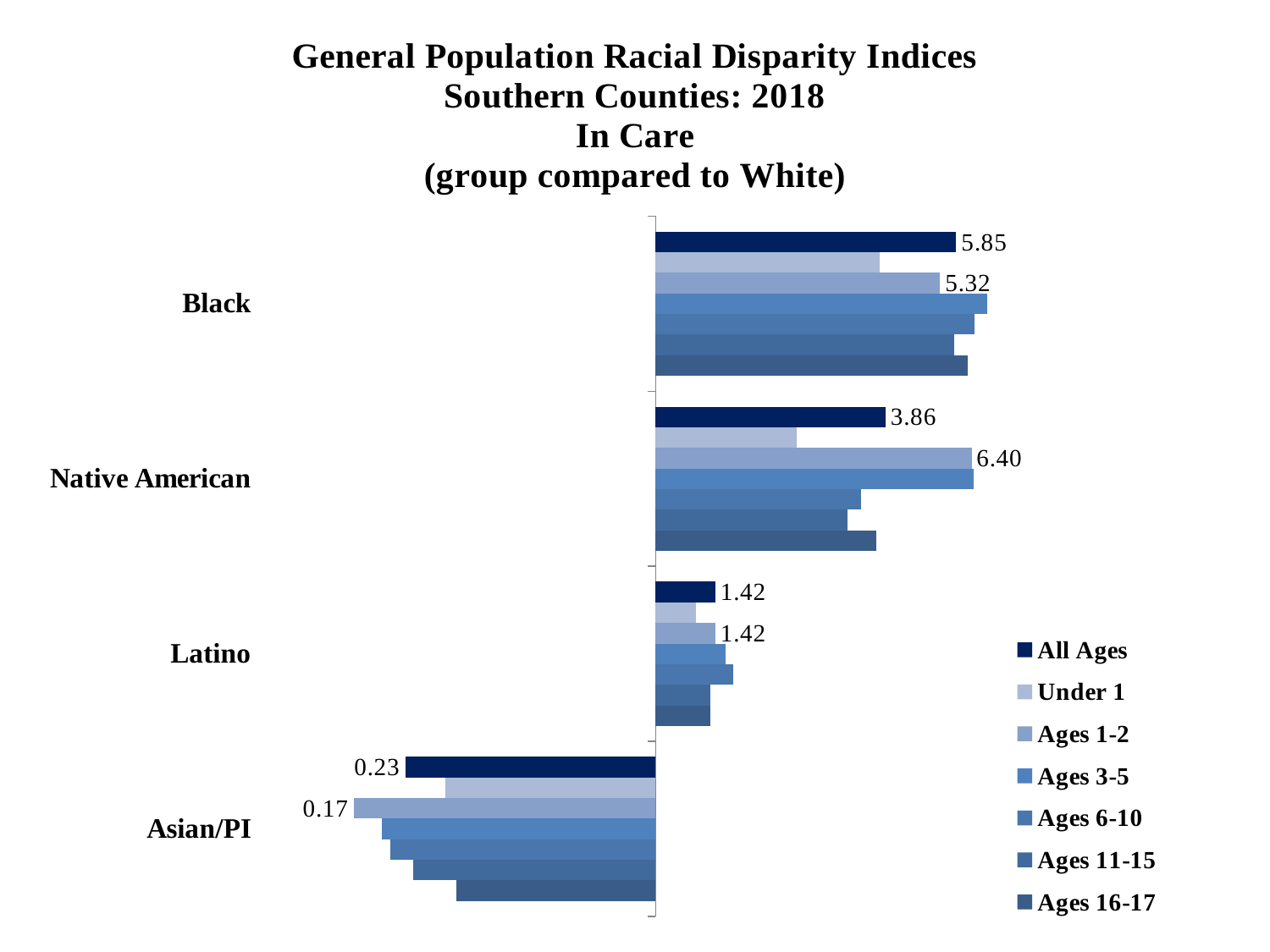
What kind of chart is shown on the slide? bar chart What is the difference between the All Ages index for Black and the All Ages index for Native American? 1.99 What is the All Ages disparity index for Black? 5.85 What is the All Ages disparity index for Asian/PI? 0.23 Which group has the highest All Ages disparity index? Black How many racial groups are shown on the chart? 4 Which group has the lowest All Ages disparity index? Asian/PI Which series is listed first in the legend? All Ages What is the Ages 1-2 disparity index for Native American? 6.40 Which is larger: the Ages 1-2 index for Native American or the Ages 1-2 index for Black? Native American How many series does the legend list? 7 What is the Ages 1-2 disparity index for Latino? 1.42